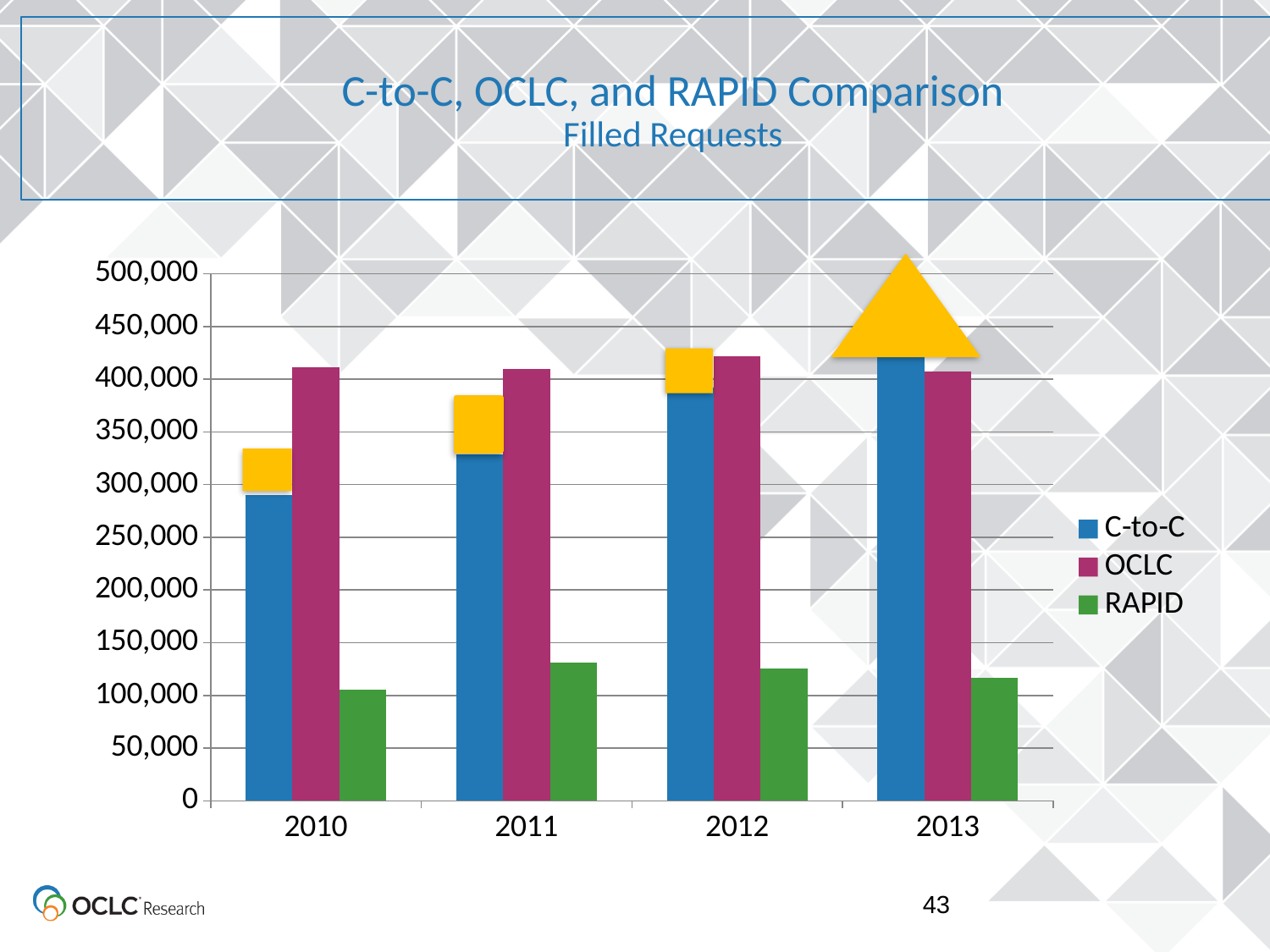
Is the value for C-to-C in 2010 greater or less than 300,000? less In 2010, which is larger, the C-to-C value or the OCLC value? OCLC What is the subtitle of the chart? Filled Requests What kind of chart is shown on the slide? bar chart Which series is represented by the green bars? RAPID Do the C-to-C values rise or fall from 2010 to 2013? rise Is the value for C-to-C in 2013 greater or less than 400,000? greater Is the value for RAPID in 2011 greater or less than 100,000? greater How many years are shown on the x axis? 4 How many series does the legend list? 3 Which series has the lowest value in 2012? RAPID